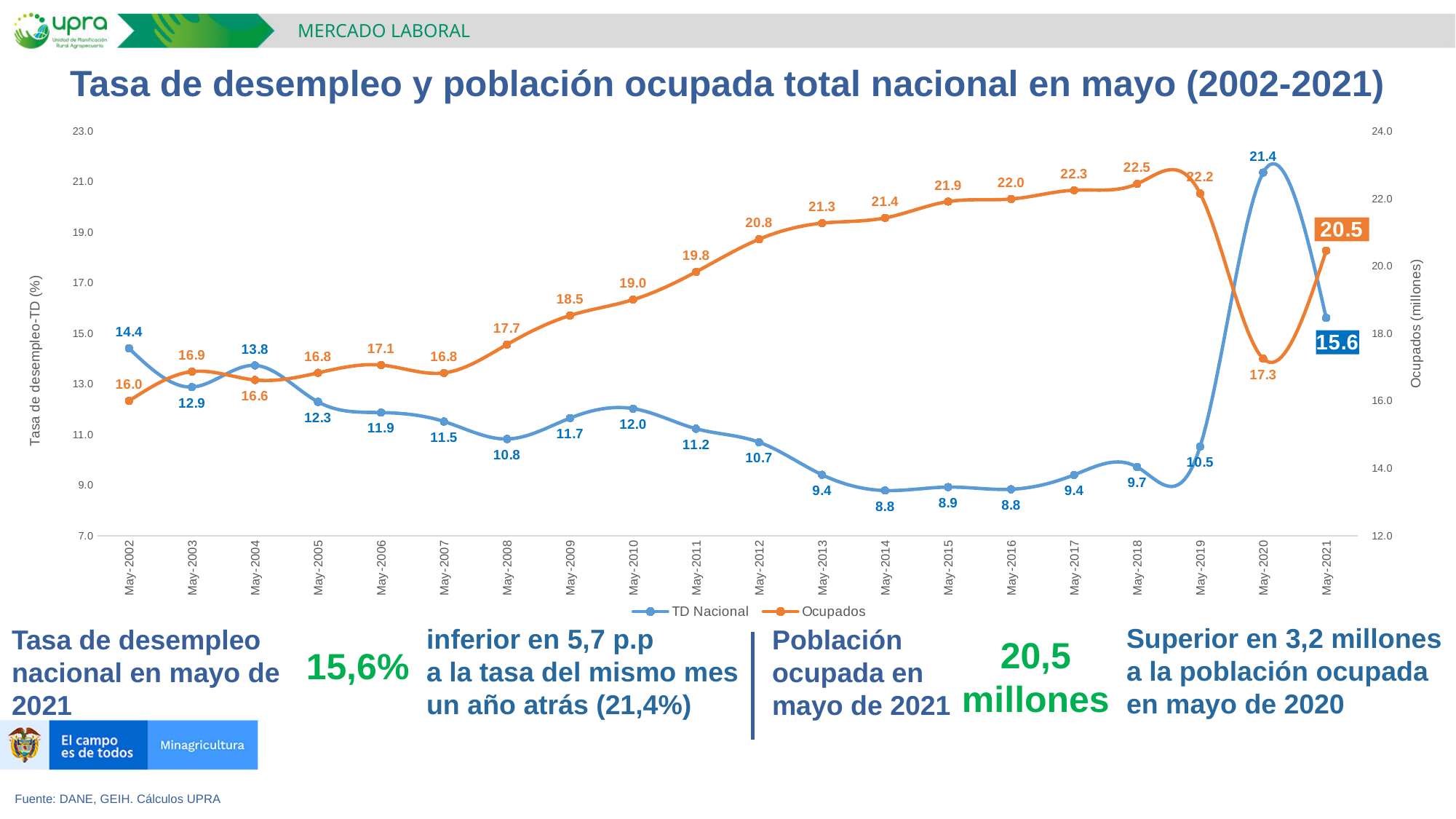
What is the value of TD Nacional for May-2008? 10.8 What is the difference between the Ocupados values for May-2021 and May-2020? 3.2 Which is larger, the TD Nacional value for May-2002 or for May-2004? May-2002 In which year does Ocupados have its lowest value? May-2002 How many series does the legend list? 2 In which year does TD Nacional reach its highest value? May-2020 What is the value of TD Nacional for May-2021? 15.6 In which year does Ocupados reach its highest value? May-2018 Does the Ocupados series rise or fall from May-2008 to May-2018? Rise What type of chart is shown on the slide? Line chart What is the value of Ocupados for May-2012? 20.8 How many data points (years) are plotted for each series? 20